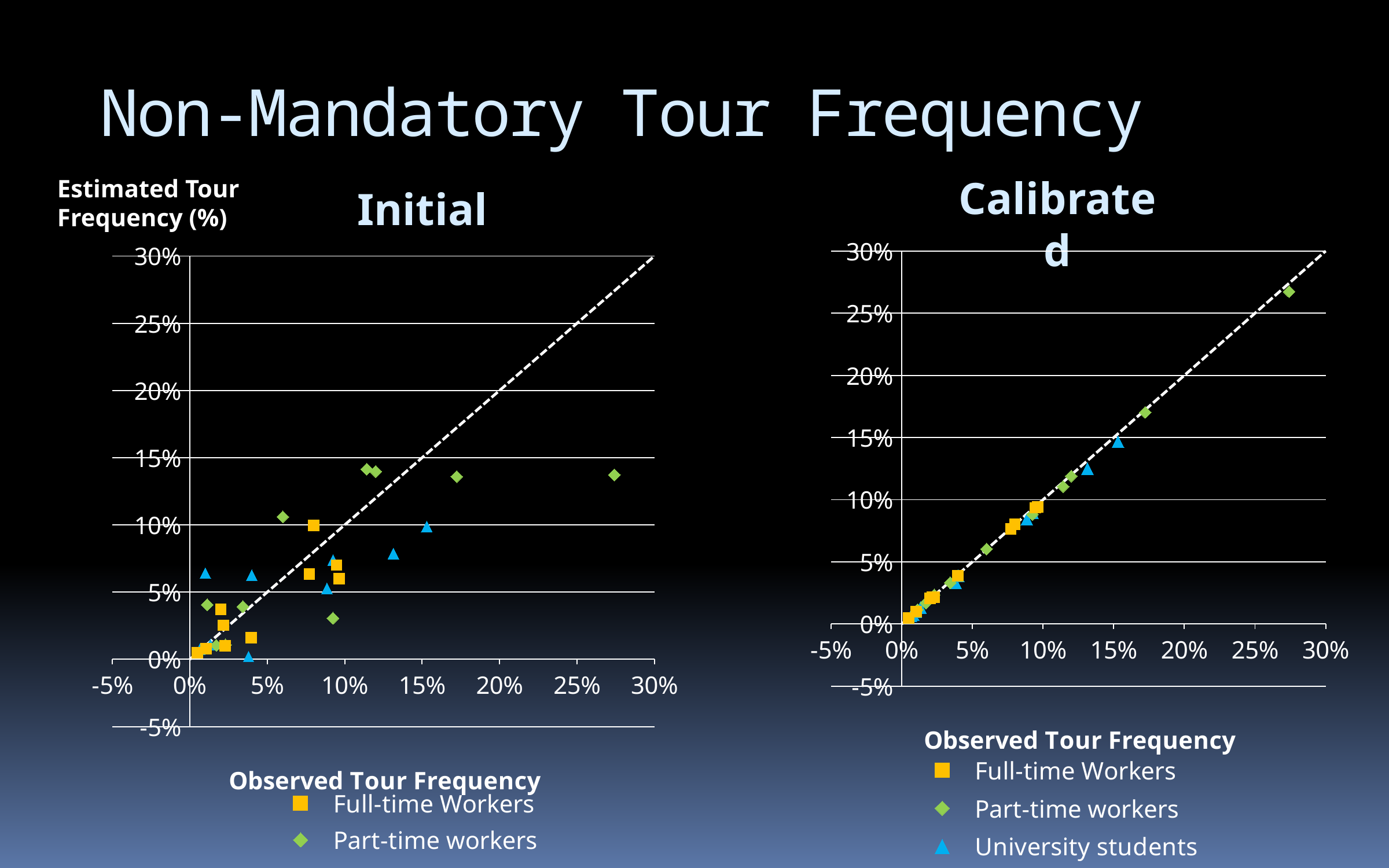
In the Initial chart, is the estimated tour frequency for the University students point at about 15% observed greater or less than 15%? less In the Calibrated chart, is the estimated tour frequency for the Part-time workers point at about 27% observed greater or less than 25%? greater What kind of chart is the Initial chart? scatter chart In the Initial chart, is the estimated tour frequency for the Part-time workers point at about 6% observed greater or less than 10%? greater How many series does the legend of the Calibrated chart list? 3 What is the x-axis label of the Calibrated chart? Observed Tour Frequency In the Calibrated chart, do the estimated tour frequency values rise or fall as observed tour frequency increases? rise How many series does the legend of the Initial chart list? 2 What kind of chart is the Calibrated chart? scatter chart What is the title of the chart on the left? Initial